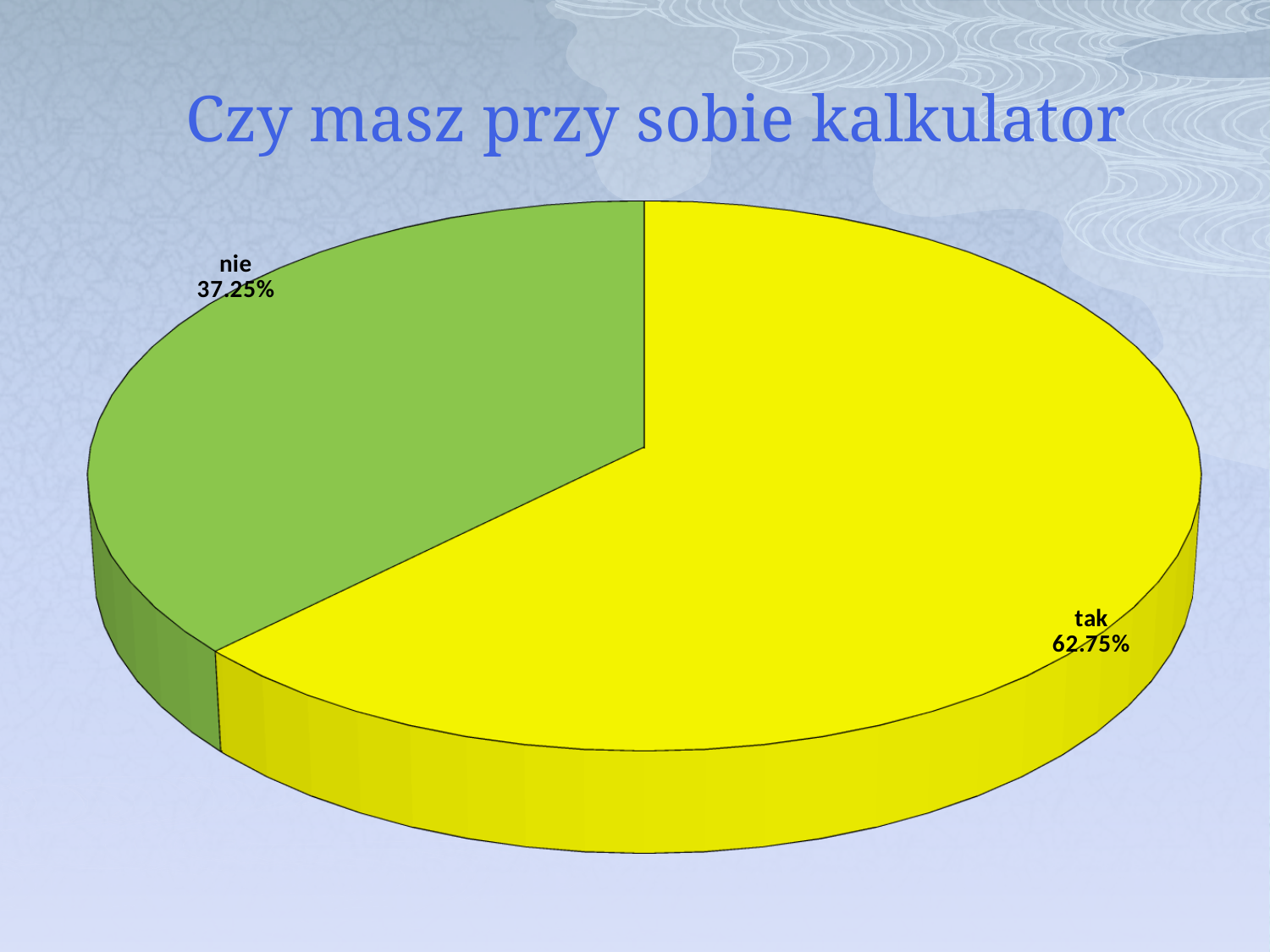
Which slice is the smallest? nie Which is larger, the "tak" slice or the "nie" slice? tak Is the share for "tak" greater or less than 50%? greater Is the share for "nie" greater or less than 50%? less What kind of chart is shown on the slide? pie chart What is the difference in percentage points between the "tak" and "nie" slices? 25.5 What is the title of the chart? Czy masz przy sobie kalkulator Which slice is the largest? tak What colour is the "nie" slice? green How many slices does the pie chart have? 2 What share of the pie does the "tak" slice represent? 62.75% What share of the pie does the "nie" slice represent? 37.25%